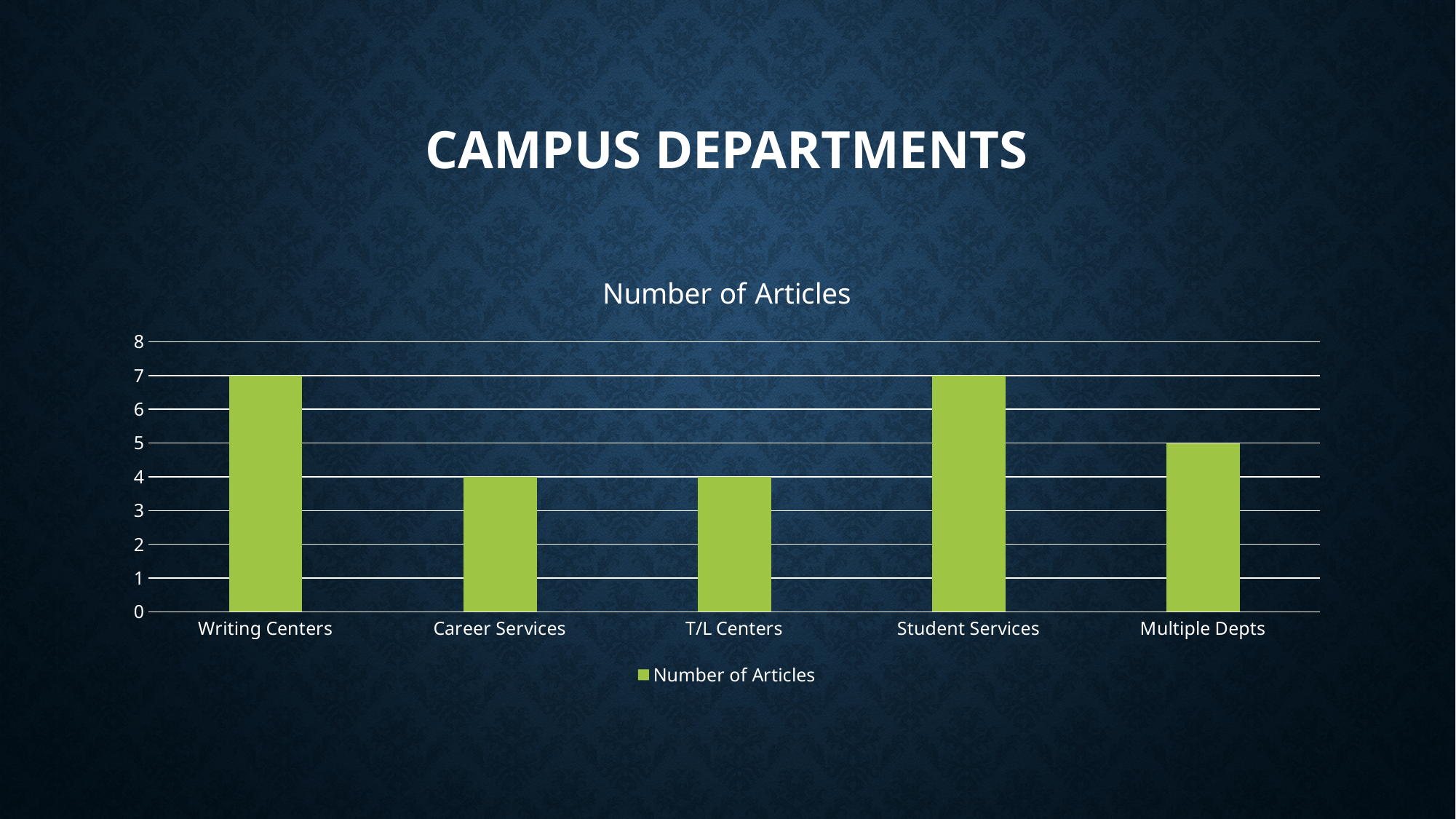
What is the difference between the values for Student Services and Multiple Depts? 2 What is the title of the chart? Number of Articles What is the difference between the values for Writing Centers and Career Services? 3 What is the value for Career Services? 4 What is the value for Multiple Depts? 5 Which is larger, the value for Multiple Depts or the value for T/L Centers? Multiple Depts What is the value for T/L Centers? 4 What is the value for Writing Centers? 7 What is the value for Student Services? 7 How many categories are shown on the x axis? 5 Is the value for Student Services greater or less than 6? greater What kind of chart is shown on the slide? bar chart